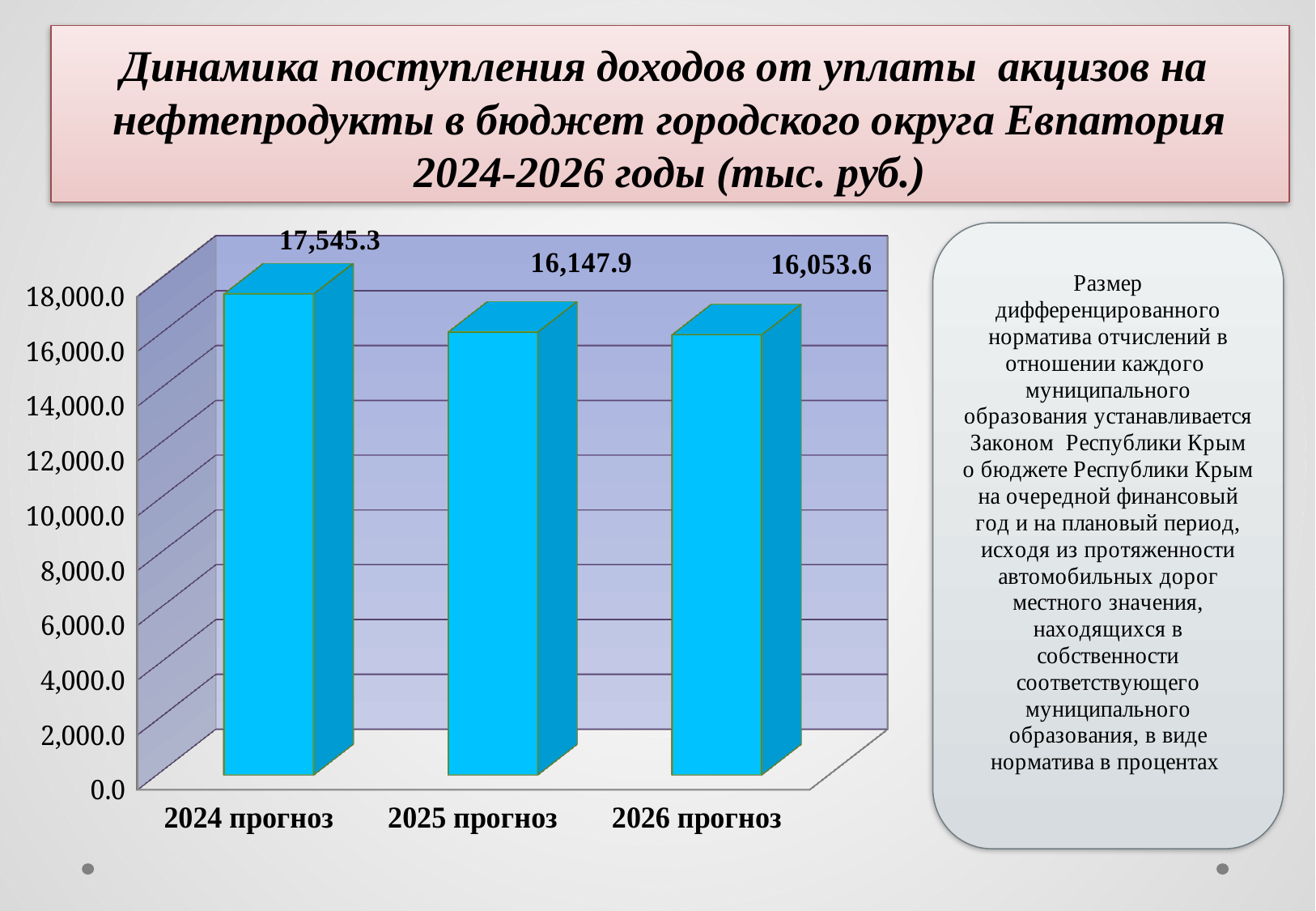
Which is larger, the value for 2025 прогноз or the value for 2026 прогноз? 2025 прогноз Is the value for 2024 прогноз greater or less than 16,000.0? greater What is the value for 2024 прогноз? 17,545.3 What kind of chart is shown on the slide? bar chart Do the values rise or fall from 2024 прогноз to 2026 прогноз? fall How many categories are shown on the x axis? 3 What is the value for 2025 прогноз? 16,147.9 Which category has the lowest value? 2026 прогноз Which category has the highest value? 2024 прогноз What is the value for 2026 прогноз? 16,053.6 What is the difference between the values for 2025 прогноз and 2026 прогноз? 94.3 What is the difference between the values for 2024 прогноз and 2025 прогноз? 1,397.4